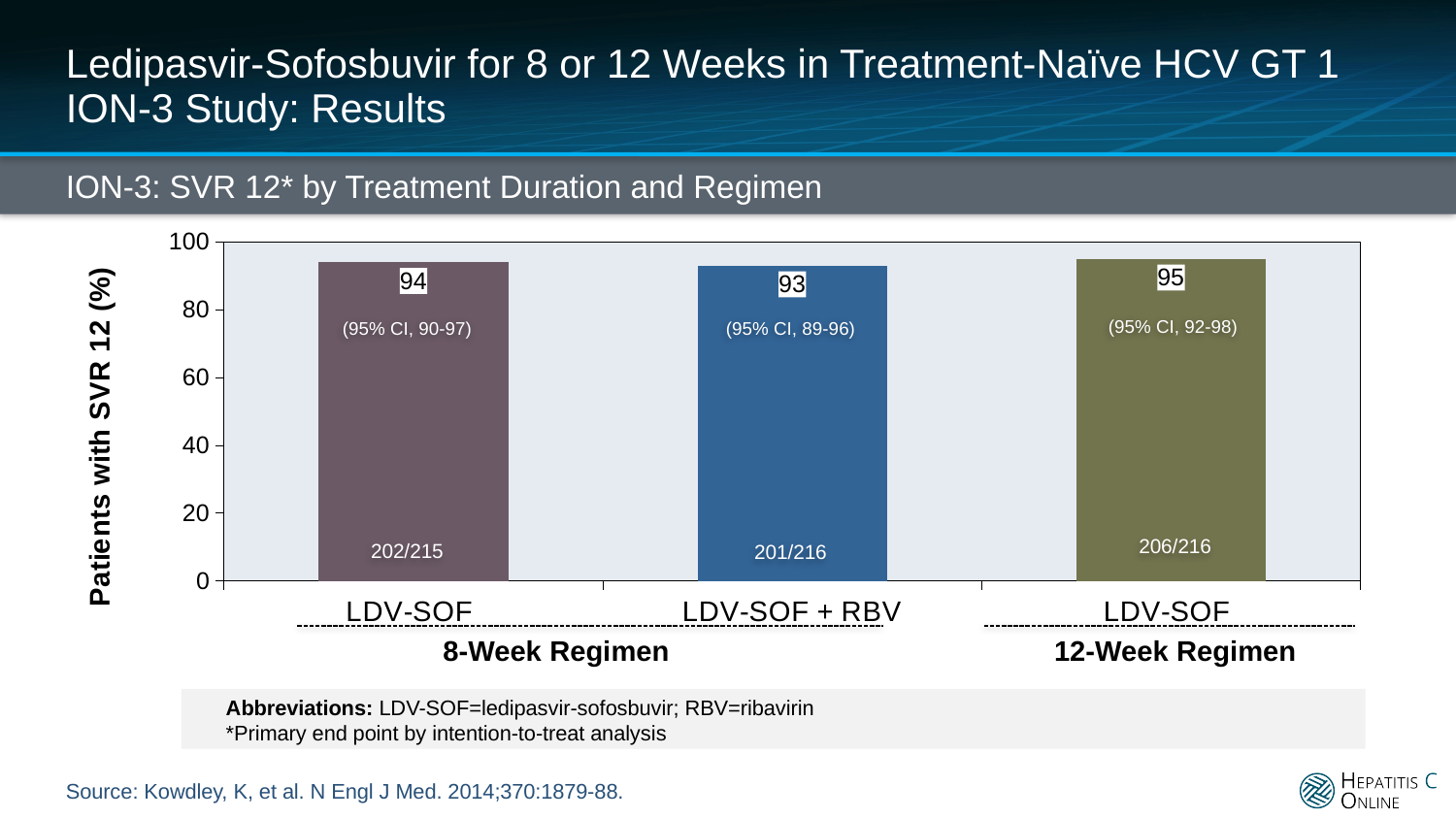
Is the SVR 12 rate for LDV-SOF in the 8-week regimen greater or less than 80? greater Which bar has the highest SVR 12 rate? LDV-SOF, 12-Week Regimen How many patients achieved SVR 12 out of the total in the LDV-SOF 12-week regimen group? 206/216 What is the difference in SVR 12 rate between LDV-SOF in the 12-week regimen and LDV-SOF + RBV in the 8-week regimen? 2 Which bar has the lowest SVR 12 rate? LDV-SOF + RBV, 8-Week Regimen What is the SVR 12 rate for LDV-SOF in the 12-week regimen? 95 What is the 95% confidence interval shown for the LDV-SOF + RBV 8-week bar? 95% CI, 89-96 What is the SVR 12 rate for LDV-SOF in the 8-week regimen? 94 What type of chart is shown on the slide? bar chart What is the label of the y-axis? Patients with SVR 12 (%) What is the SVR 12 rate for LDV-SOF + RBV in the 8-week regimen? 93 How many bars are plotted in the chart? 3